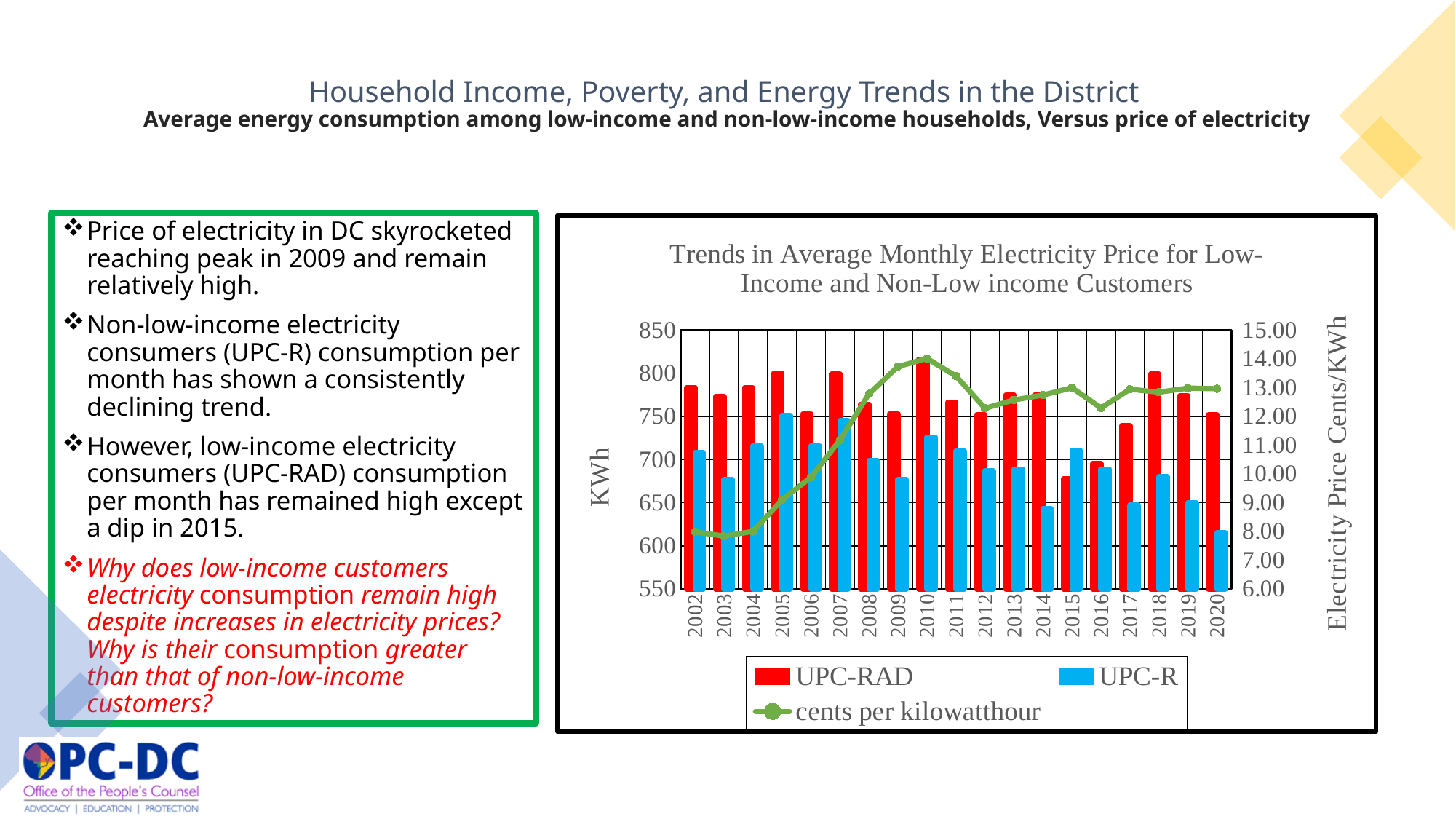
Is the cents per kilowatthour value for 2002 greater or less than 9.00? less Is the UPC-RAD value for 2015 greater or less than 700? less What is the label of the right-hand vertical axis of the chart? Electricity Price Cents/KWh Does the cents per kilowatthour line rise or fall from 2002 to 2010? rise What is the title of the chart? Trends in Average Monthly Electricity Price for Low-Income and Non-Low income Customers Is the cents per kilowatthour value for 2010 greater or less than 13.00? greater What kind of chart is shown on the slide? A bar chart combined with a line In 2015, which is larger, the UPC-RAD value or the UPC-R value? UPC-R How many years are shown on the x axis of the chart? 19 How many series does the chart legend list? 3